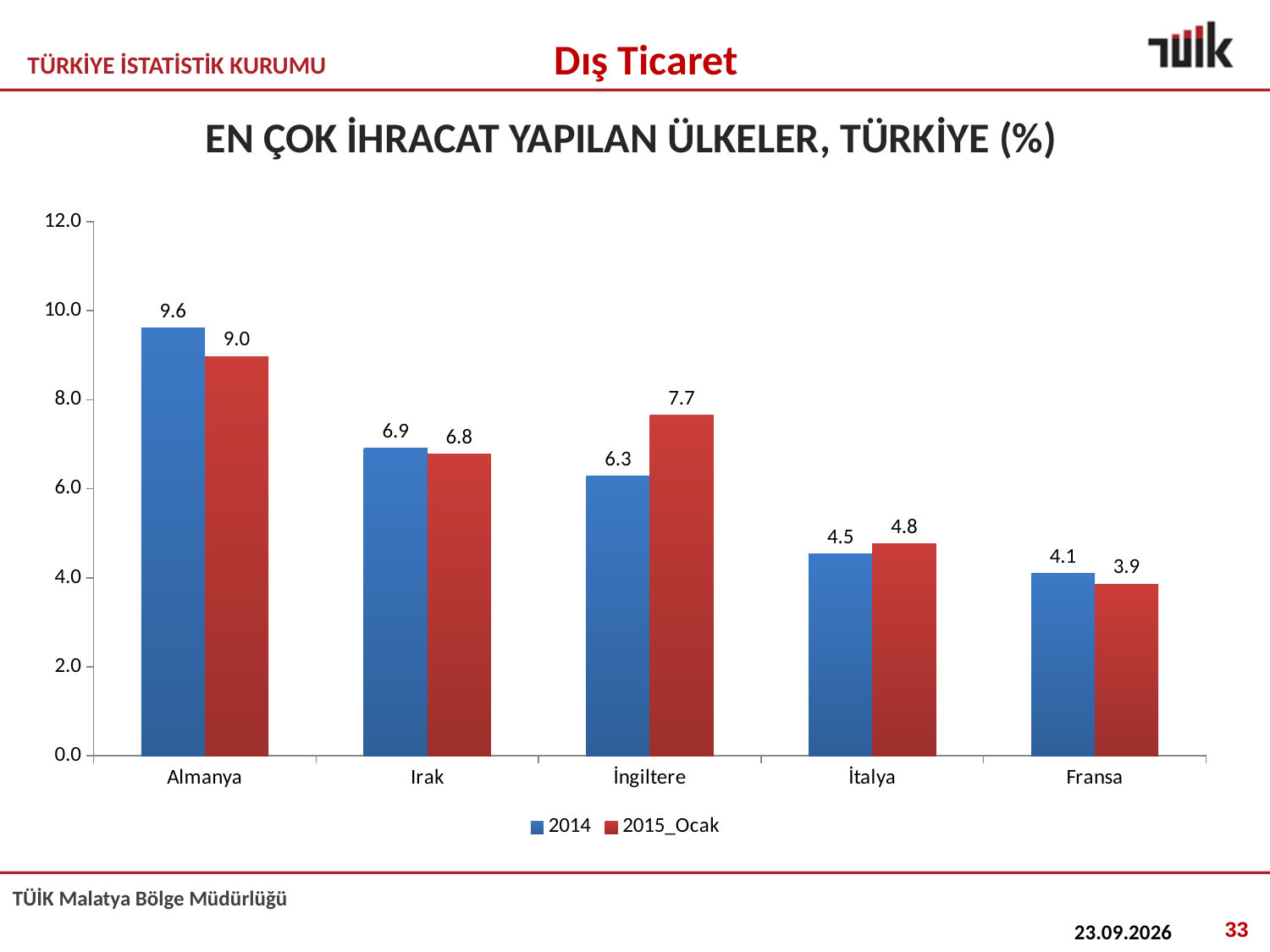
Do the 2014 values rise or fall from Almanya to Fransa along the x axis? Fall Which is larger for İtalya: the 2014 value or the 2015_Ocak value? 2015_Ocak What is the 2015_Ocak value for İngiltere? 7.7 Which country has the highest 2014 value? Almanya Which country has the lowest 2015_Ocak value? Fransa What kind of chart is shown on the slide? Bar chart How many countries are shown on the x axis? 5 What is the difference between the 2014 and 2015_Ocak values for İngiltere? 1.4 What is the 2015_Ocak value for Fransa? 3.9 What is the 2014 value for Almanya? 9.6 What is the difference between the 2014 values for Almanya and Irak? 2.7 How many series does the legend list? 2